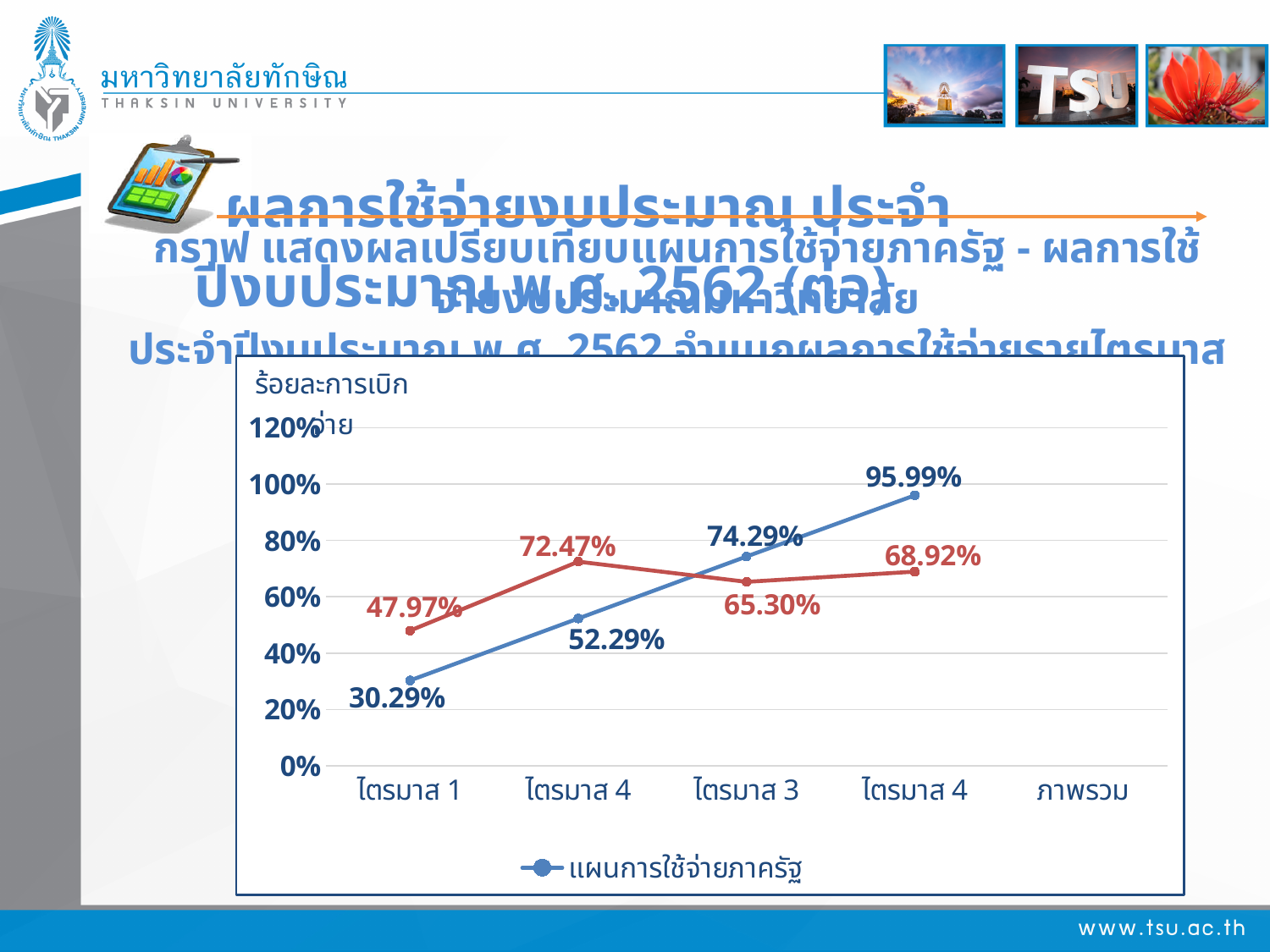
How many series does the legend list? 1 How many categories are shown on the x axis? 5 What kind of chart is shown on the slide? line chart What is the value of the แผนการใช้จ่ายภาครัฐ line at ไตรมาส 3? 74.29% What is the highest value on the แผนการใช้จ่ายภาครัฐ line? 95.99% What is the value of the red line at ไตรมาส 1? 47.97% What is the lowest value on the red line? 47.97% At ไตรมาส 1, how much higher is the red line than the แผนการใช้จ่ายภาครัฐ line? 17.68 percentage points What is the value of the แผนการใช้จ่ายภาครัฐ line at ไตรมาส 1? 30.29% Does the แผนการใช้จ่ายภาครัฐ line rise or fall from ไตรมาส 1 to its last plotted point? rise What is the value of the red line at ไตรมาส 3? 65.30% At ไตรมาส 3, which line has the larger value, the red line or the แผนการใช้จ่ายภาครัฐ line? แผนการใช้จ่ายภาครัฐ